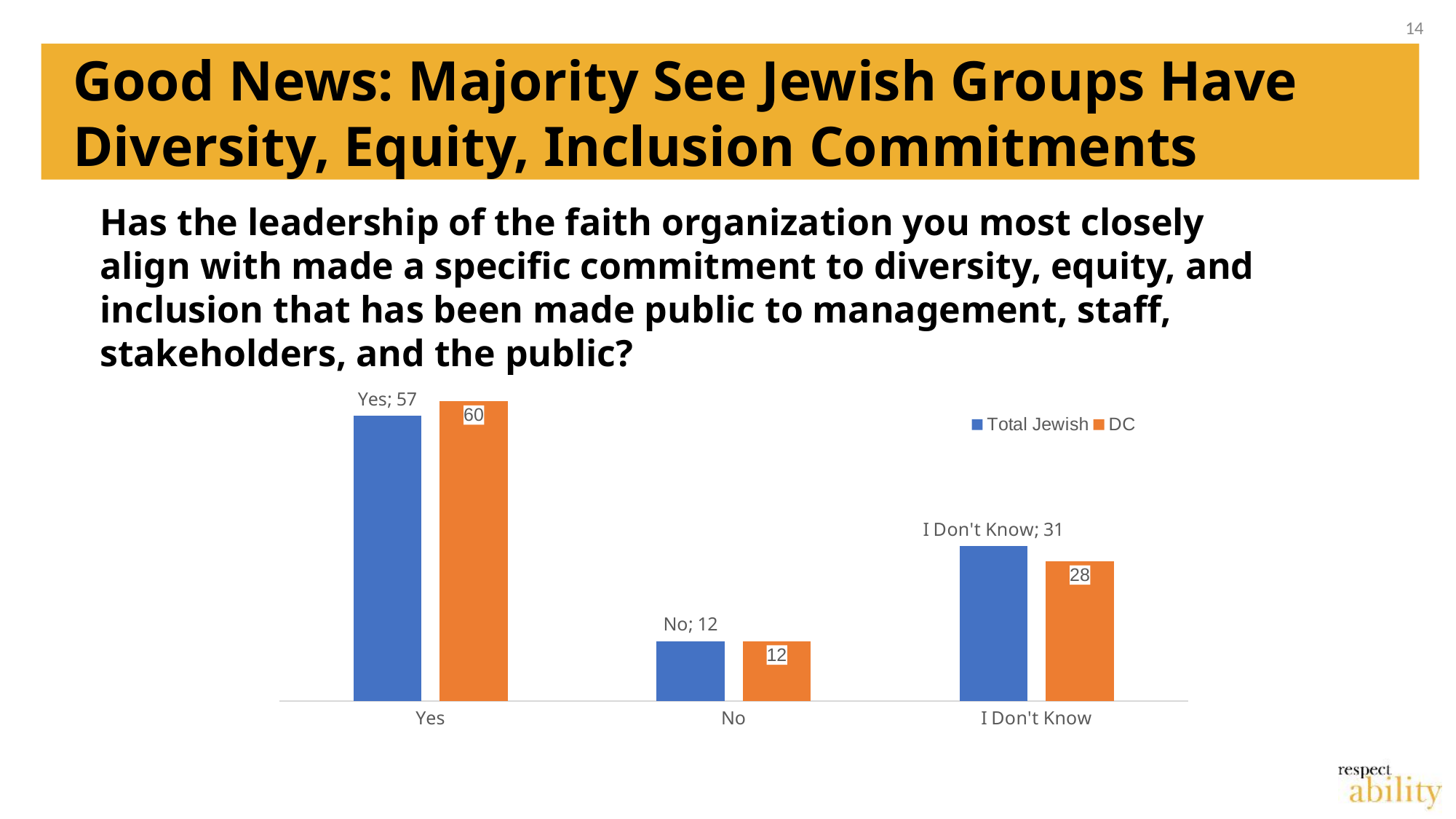
What is the Total Jewish value for I Don't Know? 31 Which colour represents the DC series? Orange Which category has the highest Total Jewish value? Yes How many categories are shown on the x axis? 3 What is the difference between the DC and Total Jewish values for Yes? 3 What is the DC value for Yes? 60 What is the Total Jewish value for Yes? 57 How many series does the legend list? 2 Which is larger for I Don't Know: Total Jewish or DC? Total Jewish Which category has the lowest DC value? No What kind of chart is shown on the slide? Bar chart What is the DC value for No? 12